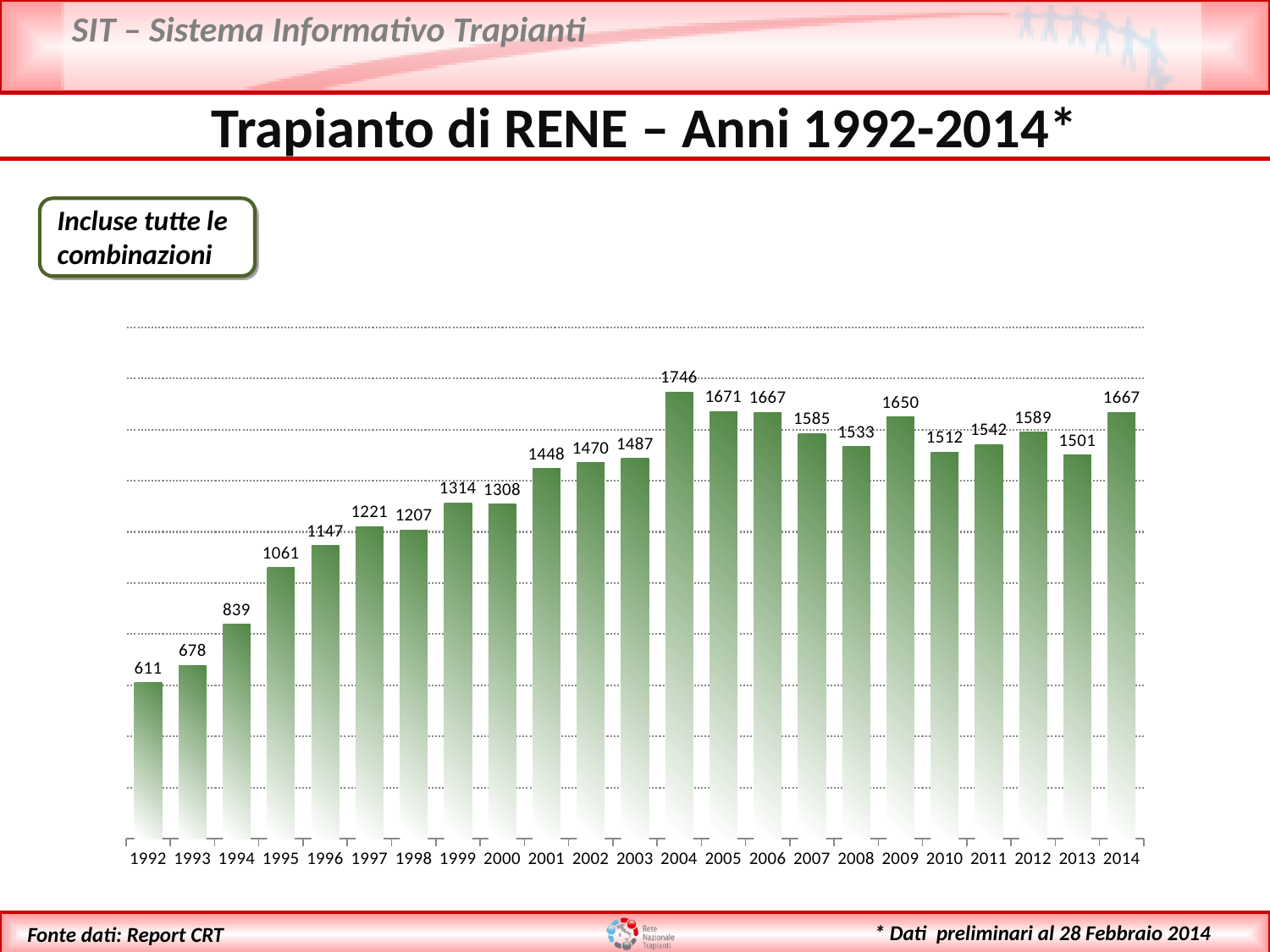
How many years are shown on the x axis? 23 What is the value for 1992? 611 What is the value for 2014? 1667 Do the values rise or fall from 1992 to 2004? rise Which is larger, the value for 2012 or the value for 2013? 2012 What is the difference between the values for 1993 and 1992? 67 Which year has the highest value? 2004 What is the value for 2004? 1746 Which year has the lowest value? 1992 What kind of chart is shown on the slide? bar chart What is the value for 2009? 1650 What is the difference between the values for 2004 and 2014? 79